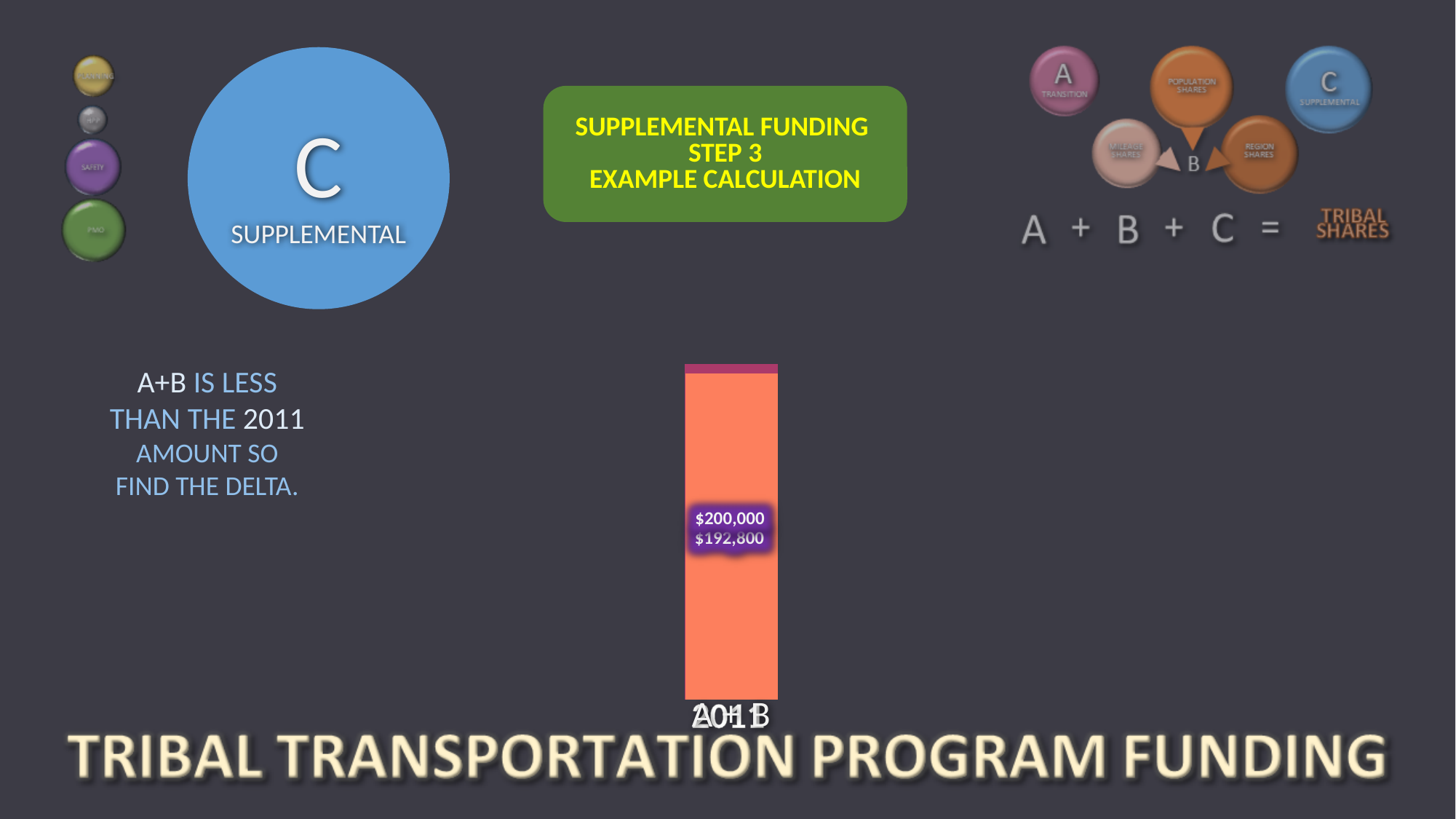
What is the smaller of the two values labelled on the bar chart? $192,800 What colour is the main bar in the chart? orange What is the title text shown in the green box above the chart? SUPPLEMENTAL FUNDING STEP 3 EXAMPLE CALCULATION What is the difference between the two values labelled on the bar chart, $200,000 and $192,800? $7,200 What kind of chart is shown on the slide? bar chart What is the larger of the two values labelled on the bar chart? $200,000 Which is larger, $200,000 or $192,800? $200,000 How many data labels are printed on the bar chart? 2 According to the slide text, is the A+B amount less than or greater than the 2011 amount? less